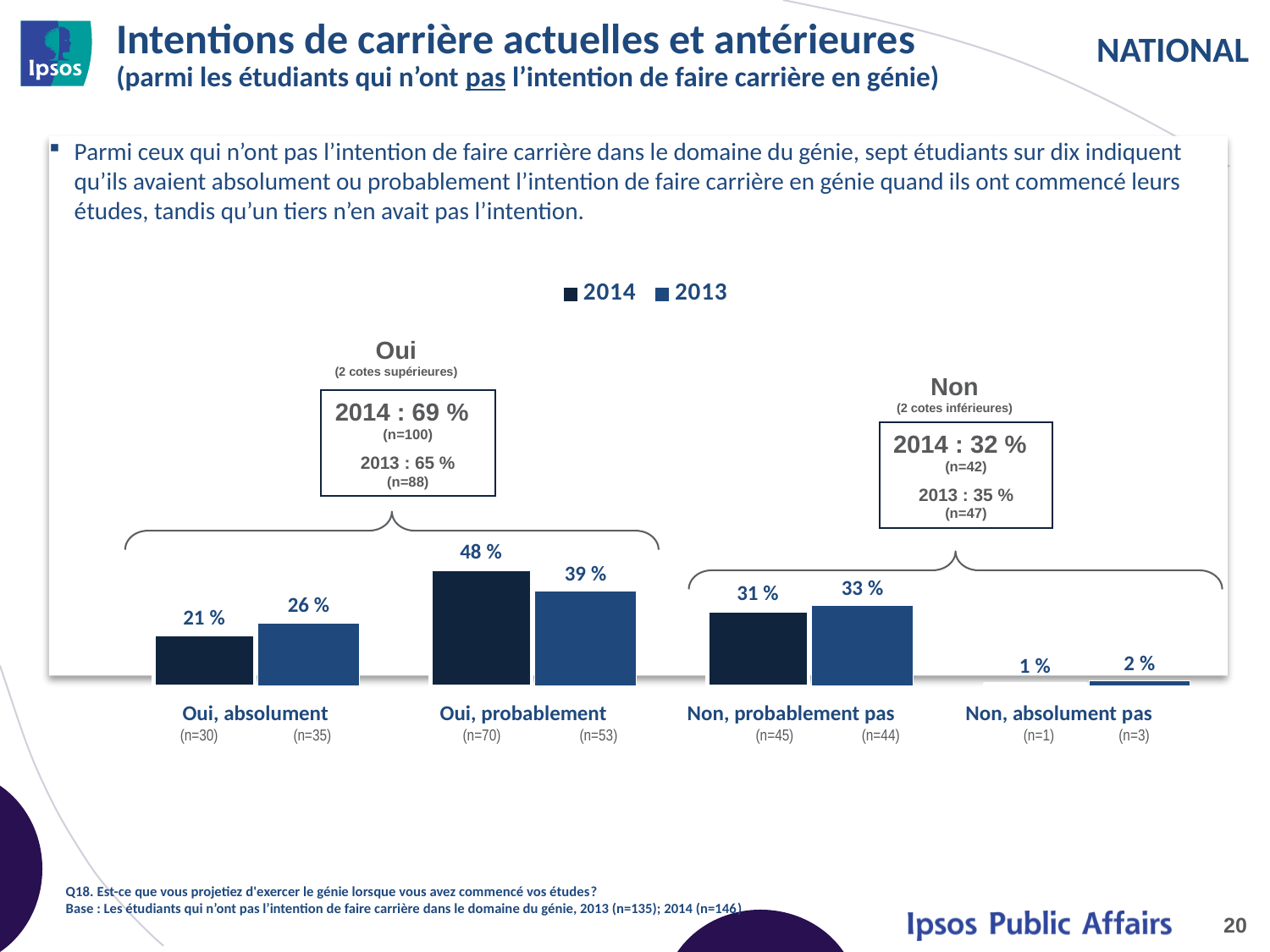
What is the 2014 value for "Oui, probablement"? 48 % How many categories are shown on the x axis of the chart? 4 What is the 2013 value for "Non, probablement pas"? 33 % Which category has the highest 2014 value? Oui, probablement What kind of chart is shown on the slide? Bar chart What are the two series named in the chart legend? 2014 and 2013 What is the 2013 value for "Oui, absolument"? 26 % How many series does the legend list? 2 What is the 2014 value for "Non, absolument pas"? 1 % Which is larger for "Oui, absolument": the 2014 value or the 2013 value? 2013 What is the difference between the 2014 and 2013 values for "Oui, probablement"? 9 % Which category has the lowest 2013 value? Non, absolument pas